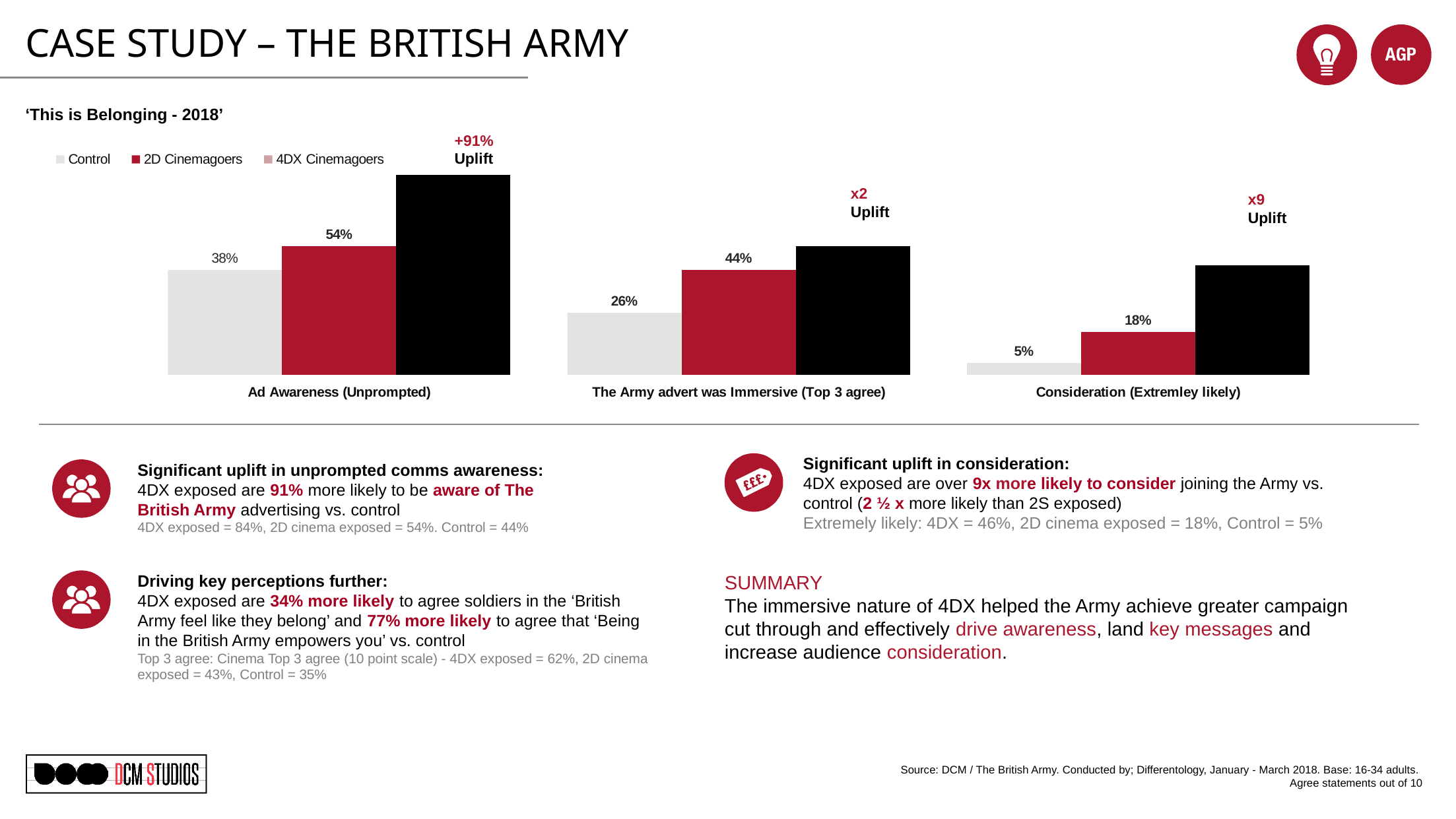
How many series does the chart legend list? 3 What is the 2D Cinemagoers value for The Army advert was Immersive (Top 3 agree)? 44% What is the 2D Cinemagoers value for Consideration (Extremley likely)? 18% What is the Control value for Consideration (Extremley likely)? 5% For Ad Awareness (Unprompted), which is larger: the 4DX Cinemagoers bar or the 2D Cinemagoers bar? 4DX Cinemagoers What is the difference between the 2D Cinemagoers and Control values for The Army advert was Immersive (Top 3 agree)? 18 percentage points Which category has the highest Control value? Ad Awareness (Unprompted) What is the Control value for Ad Awareness (Unprompted)? 38% How many categories are shown on the x axis of the chart? 3 How many percentage points higher is the 2D Cinemagoers value than the Control value for Ad Awareness (Unprompted)? 16 percentage points Which category has the lowest 2D Cinemagoers value? Consideration (Extremley likely) What uplift is annotated above the Consideration (Extremley likely) bars? x9 Uplift